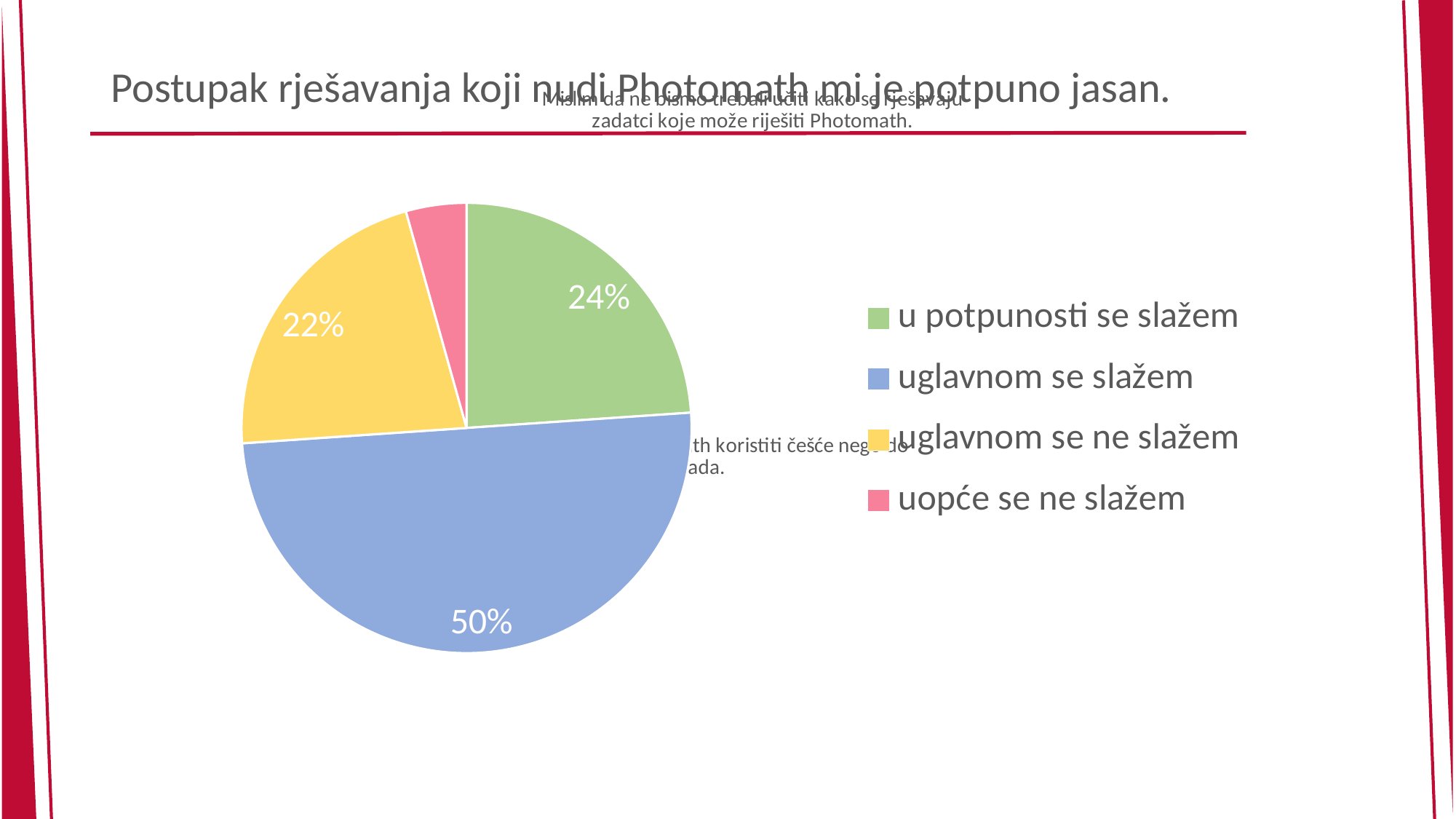
What kind of chart is shown on the slide? pie chart What percentage of the pie chart is labelled for "u potpunosti se slažem"? 24% Which slice is larger: "u potpunosti se slažem" or "uglavnom se ne slažem"? u potpunosti se slažem What is the difference in percentage points between the "u potpunosti se slažem" slice and the "uglavnom se ne slažem" slice? 2 What percentage of the pie chart is labelled for "uglavnom se ne slažem"? 22% What percentage of the pie chart is labelled for "uglavnom se slažem"? 50% How many categories does the pie chart show? 4 What colour is the "uglavnom se ne slažem" slice in the pie chart? yellow What is the difference in percentage points between the "uglavnom se slažem" slice and the "u potpunosti se slažem" slice? 26 Which category has the largest slice of the pie chart? uglavnom se slažem What share of the pie does the "uglavnom se slažem" slice represent? 50% Which category has the smallest slice of the pie chart? uopće se ne slažem